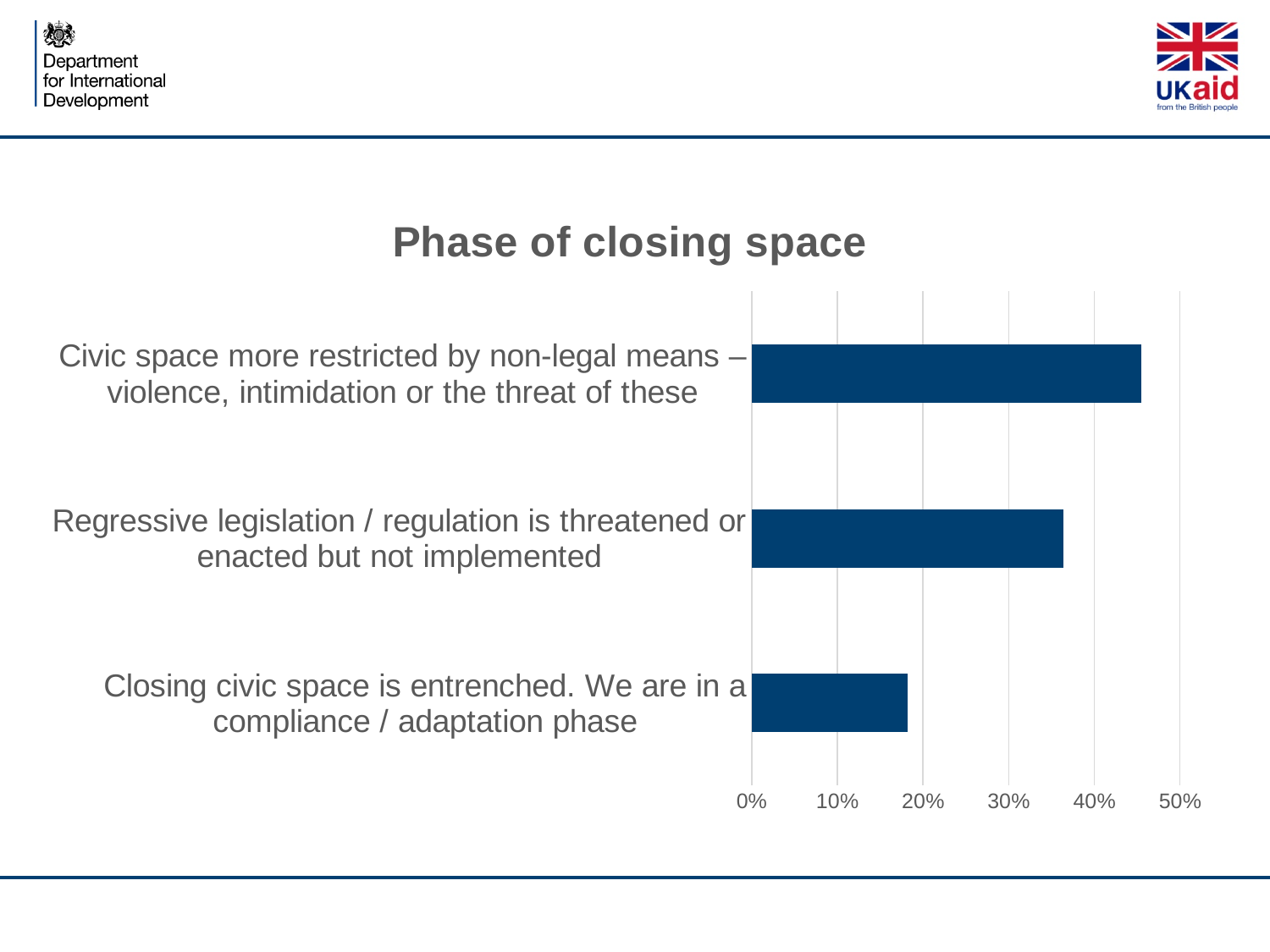
Is the value for "Civic space more restricted by non-legal means – violence, intimidation or the threat of these" greater or less than 40%? greater Which is larger: the value for "Regressive legislation / regulation is threatened or enacted but not implemented" or the value for "Closing civic space is entrenched. We are in a compliance / adaptation phase"? Regressive legislation / regulation is threatened or enacted but not implemented Which category has the highest value? Civic space more restricted by non-legal means – violence, intimidation or the threat of these Is the value for "Regressive legislation / regulation is threatened or enacted but not implemented" greater or less than 40%? less Which category has the lowest value? Closing civic space is entrenched. We are in a compliance / adaptation phase Is the value for "Closing civic space is entrenched. We are in a compliance / adaptation phase" greater or less than 10%? greater How many categories are plotted in the chart? 3 What kind of chart is shown on the slide? bar chart What is the title of the chart? Phase of closing space